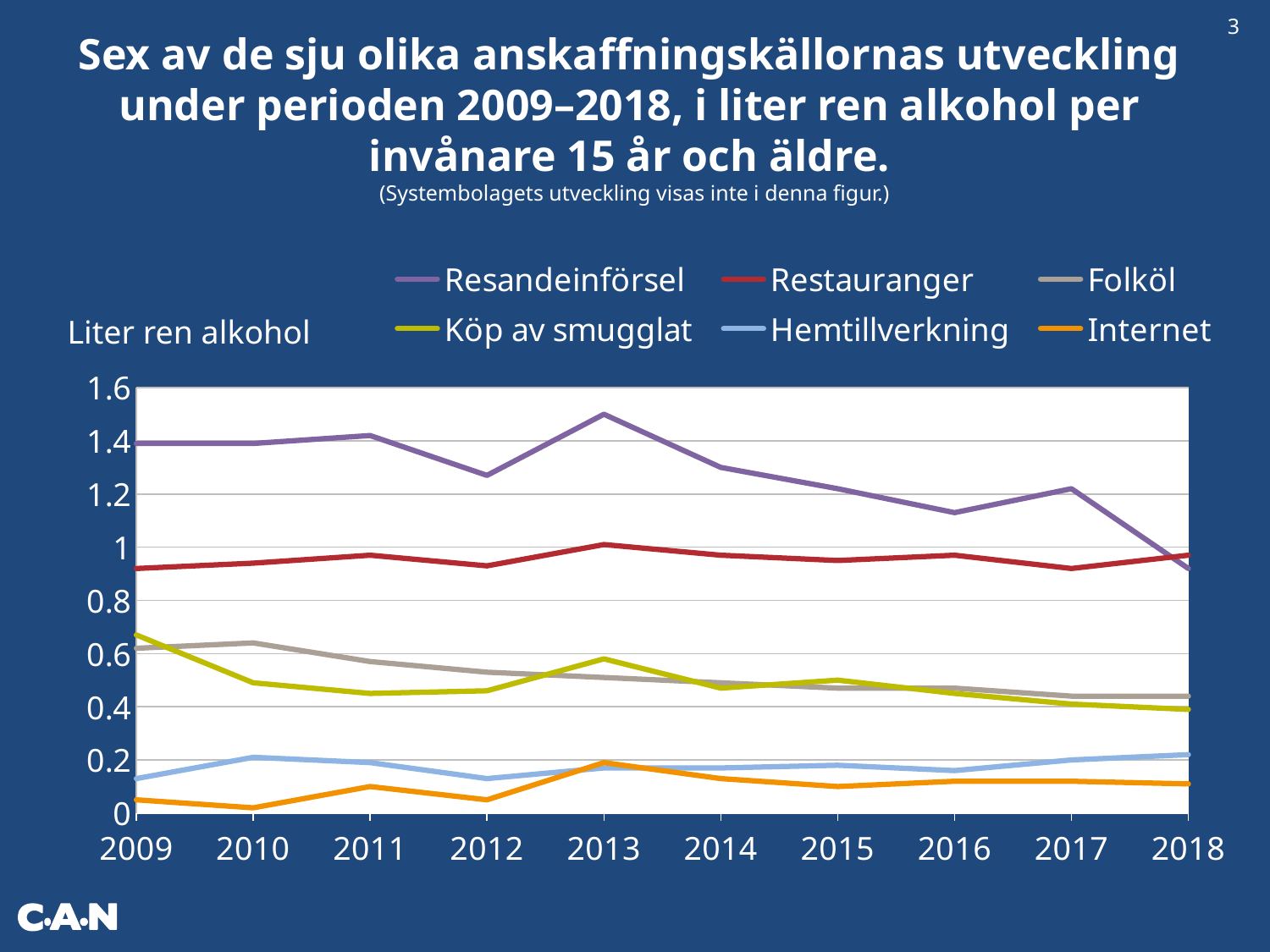
In which year does Resandeinförsel reach its lowest value? 2018 Is the value for Köp av smugglat in 2009 greater or less than 0.6? greater How many years are shown on the x axis? 10 What kind of chart is shown on the slide? Line chart In 2016, which is larger: Resandeinförsel or Restauranger? Resandeinförsel Is the value for Resandeinförsel in 2013 greater or less than 1.4? greater Which series has the lowest value in 2010? Internet Is the value for Internet in 2010 greater or less than 0.2? less In which year does Resandeinförsel reach its highest value? 2013 Which series has the highest value in 2013? Resandeinförsel Does the value for Köp av smugglat rise or fall from 2009 to 2018? fall How many series does the legend list? 6